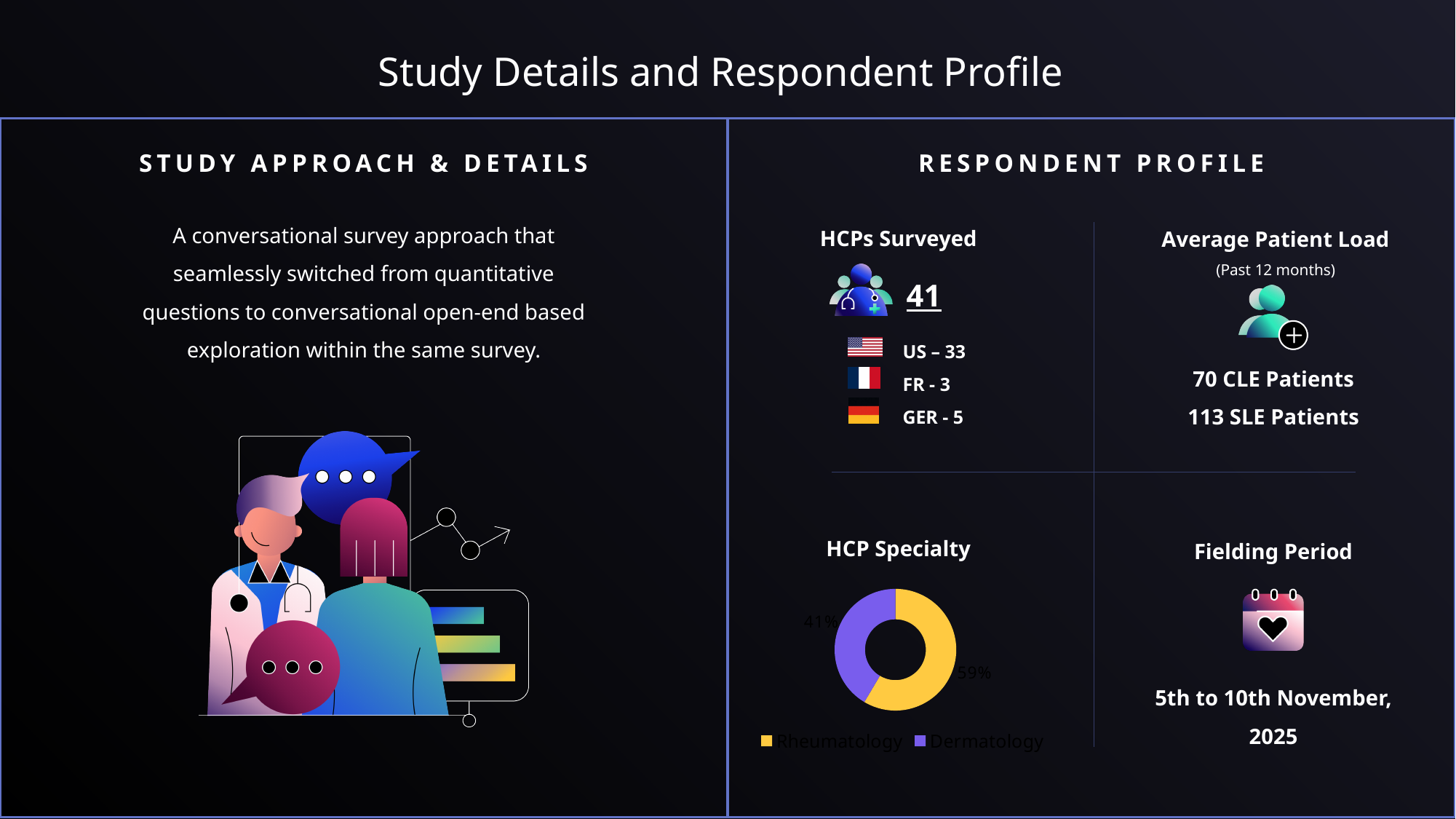
In the HCP Specialty chart, which specialty has the larger share? Rheumatology In the HCP Specialty chart, is the Rheumatology share greater or less than 50%? greater How many slices does the HCP Specialty chart have? 2 In the HCP Specialty chart, what is the difference in percentage points between Rheumatology and Dermatology? 18 percentage points In the HCP Specialty chart, what share of HCPs are in Rheumatology? 59% In the HCP Specialty chart, which colour represents Dermatology? Purple In the HCP Specialty chart, which colour represents Rheumatology? Yellow In the HCP Specialty chart, what share of HCPs are in Dermatology? 41% What kind of chart is shown under HCP Specialty? Pie chart (donut) In the HCP Specialty chart, which specialty has the smaller share? Dermatology How many entries does the legend of the HCP Specialty chart list? 2 In the HCP Specialty chart, is the Dermatology share larger or smaller than the Rheumatology share? Smaller